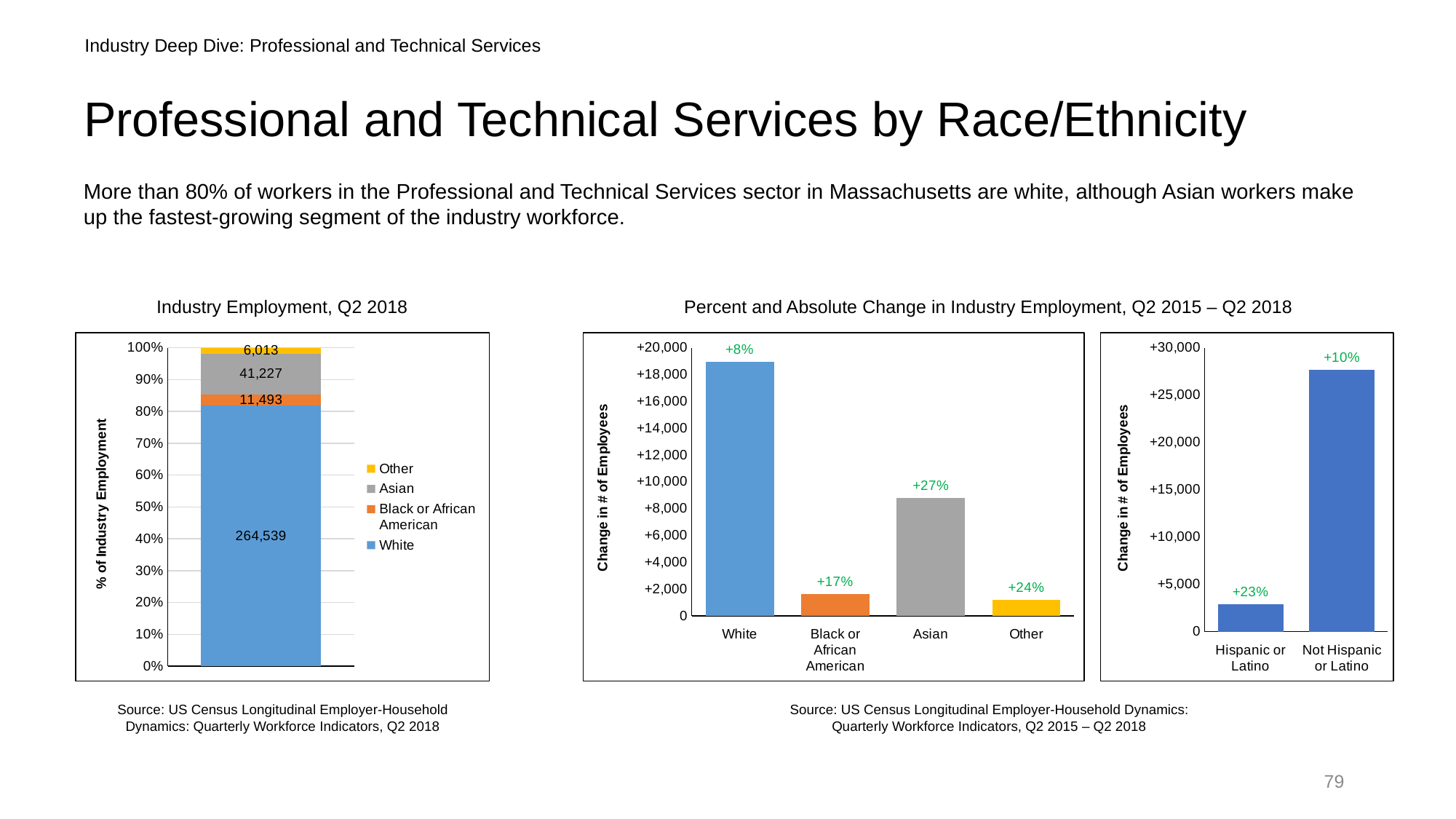
In the middle chart (Percent and Absolute Change in Industry Employment by race), is the change in number of employees for Asian greater or less than 8,000? greater In the Industry Employment, Q2 2018 chart, what is the value shown for White? 264,539 In the Industry Employment, Q2 2018 chart, what is the total of the stacked bar across all four groups? 323,272 In the middle chart (Percent and Absolute Change in Industry Employment by race), how many categories are shown on the x axis? 4 In the Industry Employment, Q2 2018 chart, what is the difference between the Asian value and the Other value? 35,214 In the middle chart (Percent and Absolute Change in Industry Employment by race), what percent change is shown for Asian? +27% In the Industry Employment, Q2 2018 chart, how many series does the legend list? 4 In the middle chart (Percent and Absolute Change in Industry Employment by race), which category has the highest change in number of employees? White In the Industry Employment, Q2 2018 chart, what is the value shown for Black or African American? 11,493 In the rightmost chart (change in employment by Hispanic or Latino status), is the change in number of employees for Not Hispanic or Latino greater or less than 25,000? greater In the Industry Employment, Q2 2018 chart, what is the value shown for Asian? 41,227 In the rightmost chart (change in employment by Hispanic or Latino status), what percent change is shown for Hispanic or Latino? +23%